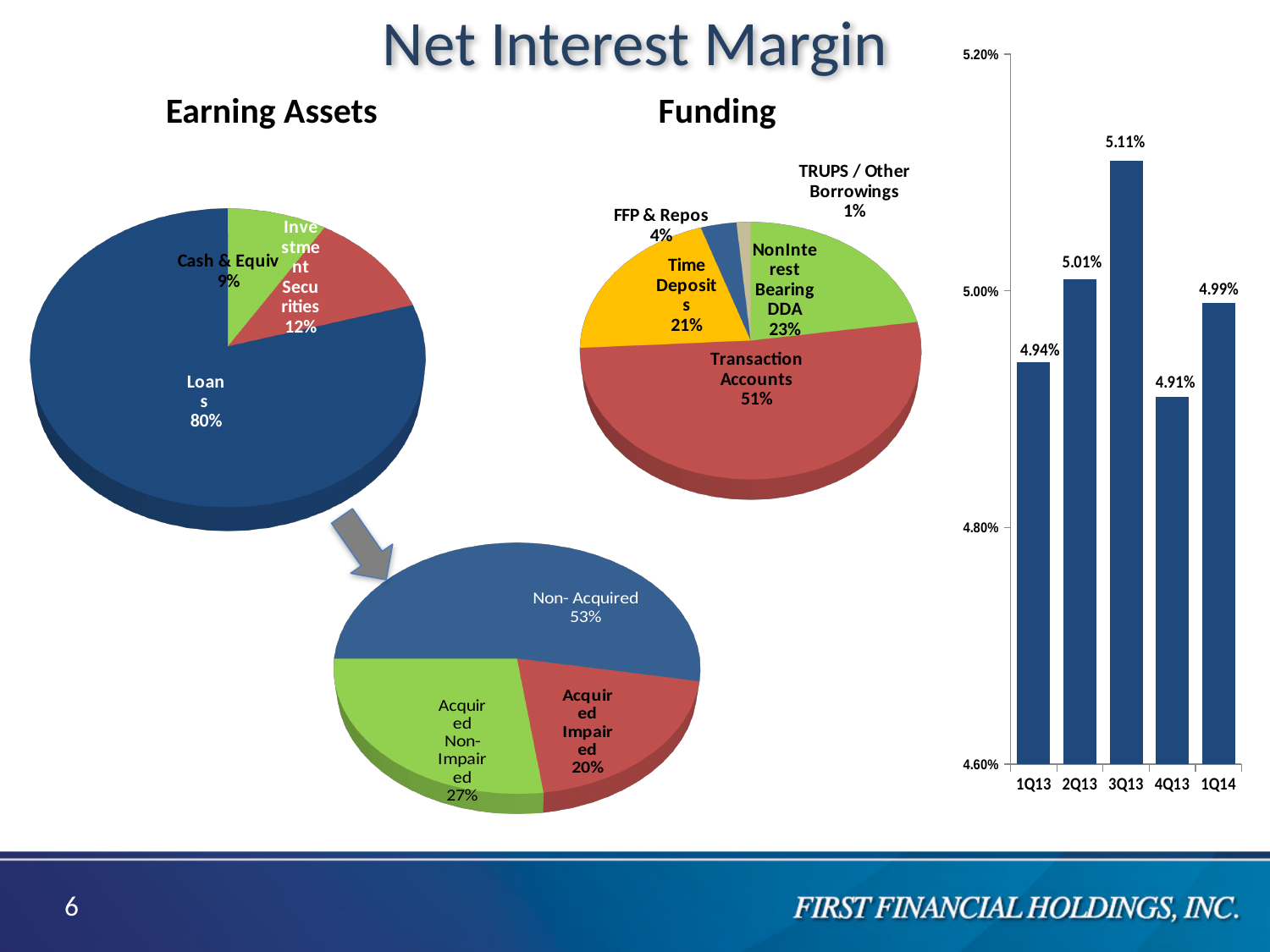
In the Funding pie chart, which category has the smallest share? TRUPS / Other Borrowings In the Earning Assets pie chart, what share do Investment Securities represent? 12% In the bar chart on the right, which quarter has the lowest value? 4Q13 In the Funding pie chart, what is the difference between the Time Deposits share and the FFP & Repos share? 17% What type of chart is shown on the right side of the slide? Bar chart In the Earning Assets pie chart, what share do Loans represent? 80% In the bar chart on the right, what is the difference between the 3Q13 and 4Q13 values? 0.20% In the Funding pie chart, how many categories are shown? 5 In the bottom pie chart showing the loan breakdown, which is larger: Acquired Non-Impaired or Acquired Impaired? Acquired Non-Impaired In the Funding pie chart, what share do Transaction Accounts represent? 51% In the bar chart on the right, what is the value for 3Q13? 5.11% In the bottom pie chart showing the loan breakdown, what share is Non-Acquired? 53%